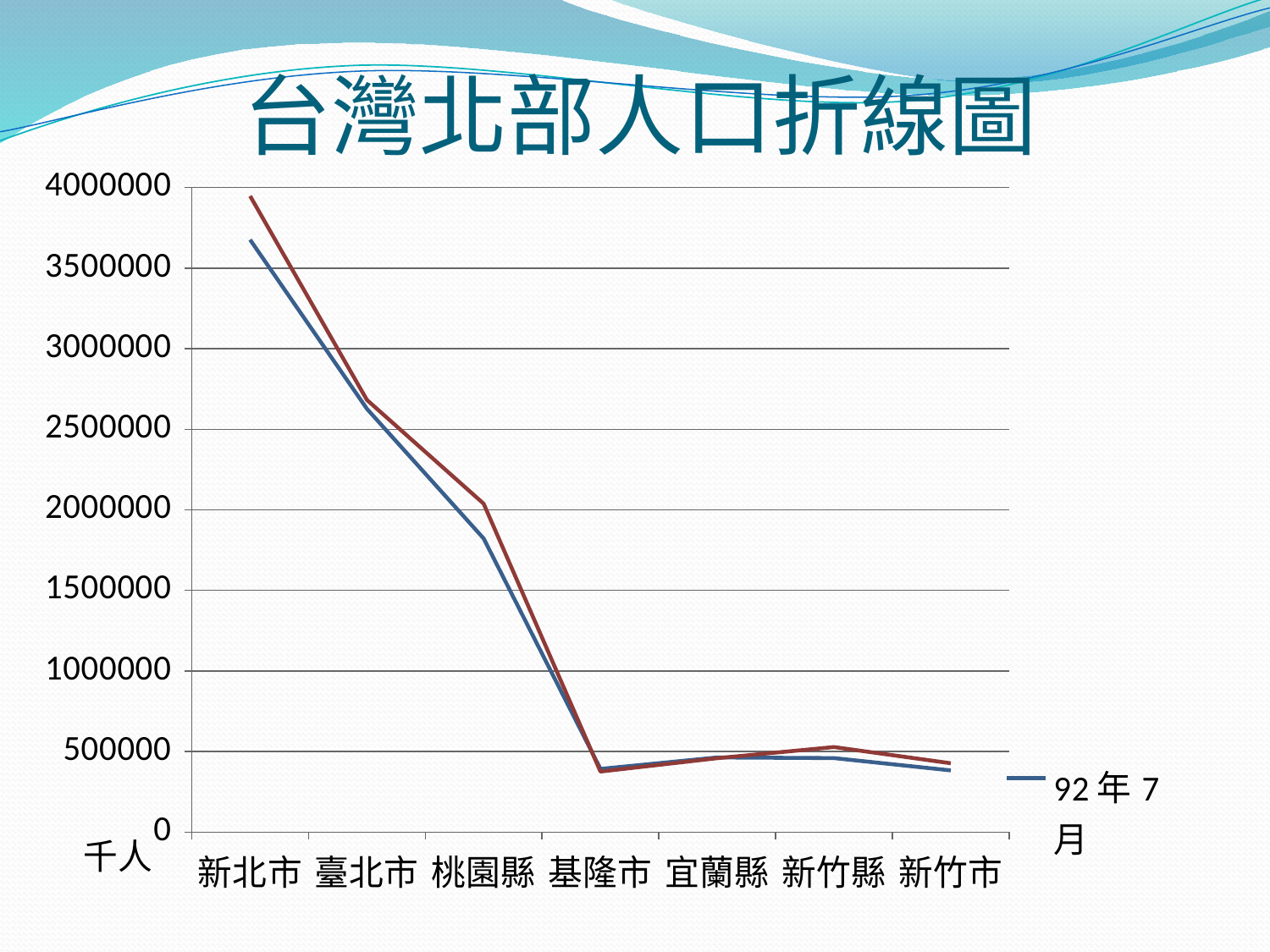
Is the value for 基隆市 in the 92年7月 series greater or less than 500000? less How many lines are plotted on the chart? 2 Which is larger for the 92年7月 series, 新北市 or 臺北市? 新北市 Which category has the highest value for the 92年7月 series? 新北市 Is the value for 桃園縣 in the 92年7月 series greater or less than 2000000? less Which is larger for the 92年7月 series, 桃園縣 or 基隆市? 桃園縣 Is the value for 臺北市 in the 92年7月 series greater or less than 3000000? less What is the title of the chart? 台灣北部人口折線圖 Do the values of the 92年7月 series rise or fall from 新北市 to 基隆市? fall What kind of chart is shown on the slide? line chart How many categories are shown on the x axis of the chart? 7